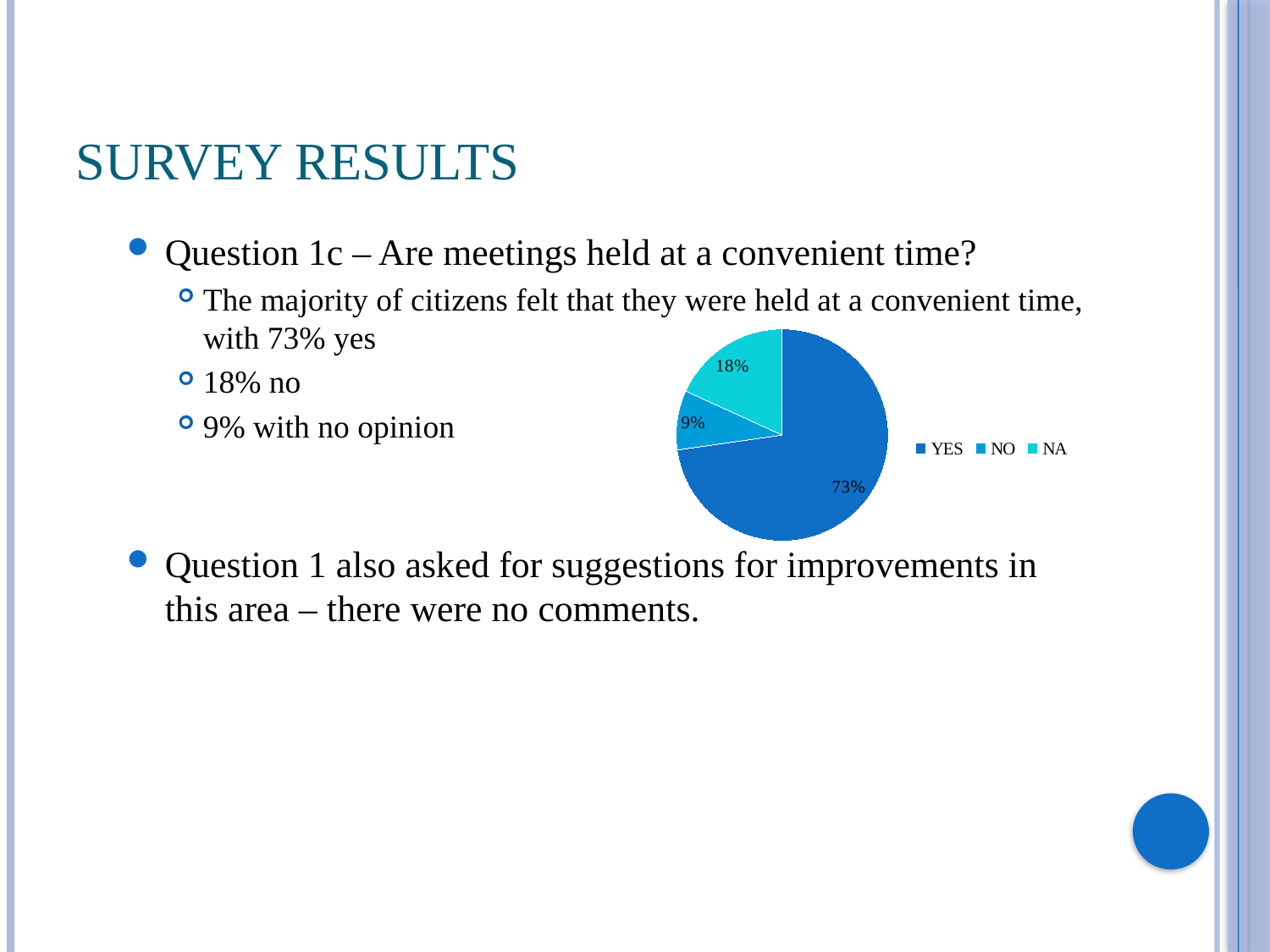
What share of the pie does the YES slice represent? 73% Is the YES slice of the pie chart larger or smaller than the NA slice? larger How many entries does the pie chart's legend list? 3 Is the value for the YES slice greater or less than 50%? greater What percentage of the pie chart is labelled for the YES slice? 73% Which slice of the pie chart is the largest? YES What kind of chart is shown on the slide? pie chart How many slices does the pie chart have? 3 What are the legend entries of the pie chart? YES, NO, NA Which legend entry is shown in the lightest (cyan) colour in the pie chart? NA